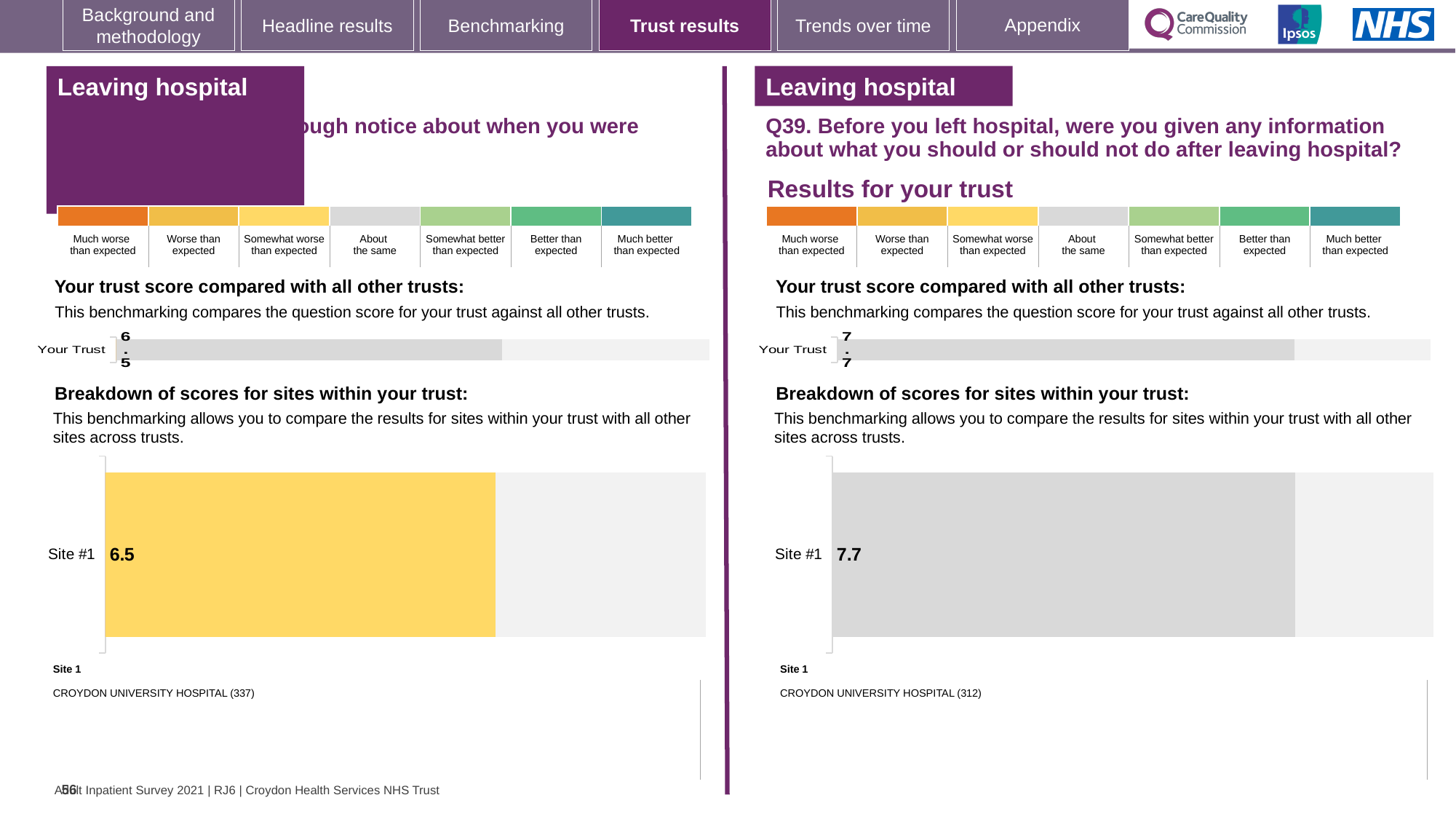
On the right-hand panel (Q39), what is the score shown for Site #1? 7.7 On the left-hand panel, what colour is the Site #1 bar? Yellow On the left-hand panel, what is the 'Your Trust' score in the trust comparison chart? 6.5 On the right-hand panel (Q39), what colour is the Site #1 bar? Grey Which hospital is listed as Site 1 on the right-hand panel (Q39)? CROYDON UNIVERSITY HOSPITAL (312) On the right-hand panel (Q39), what is the 'Your Trust' score in the trust comparison chart? 7.7 What type of chart is used to show the Site #1 score on each panel? Bar chart On the left-hand panel, what is the score shown for Site #1? 6.5 How many sites are shown in the site breakdown chart on the left-hand panel? 1 What is the difference between the Site #1 score on the right-hand panel (Q39) and the Site #1 score on the left-hand panel? 1.2 How many sites are shown in the site breakdown chart on the right-hand panel (Q39)? 1 Which Site #1 score is larger: the one on the left-hand panel or the one on the right-hand panel (Q39)? Right-hand panel (Q39)